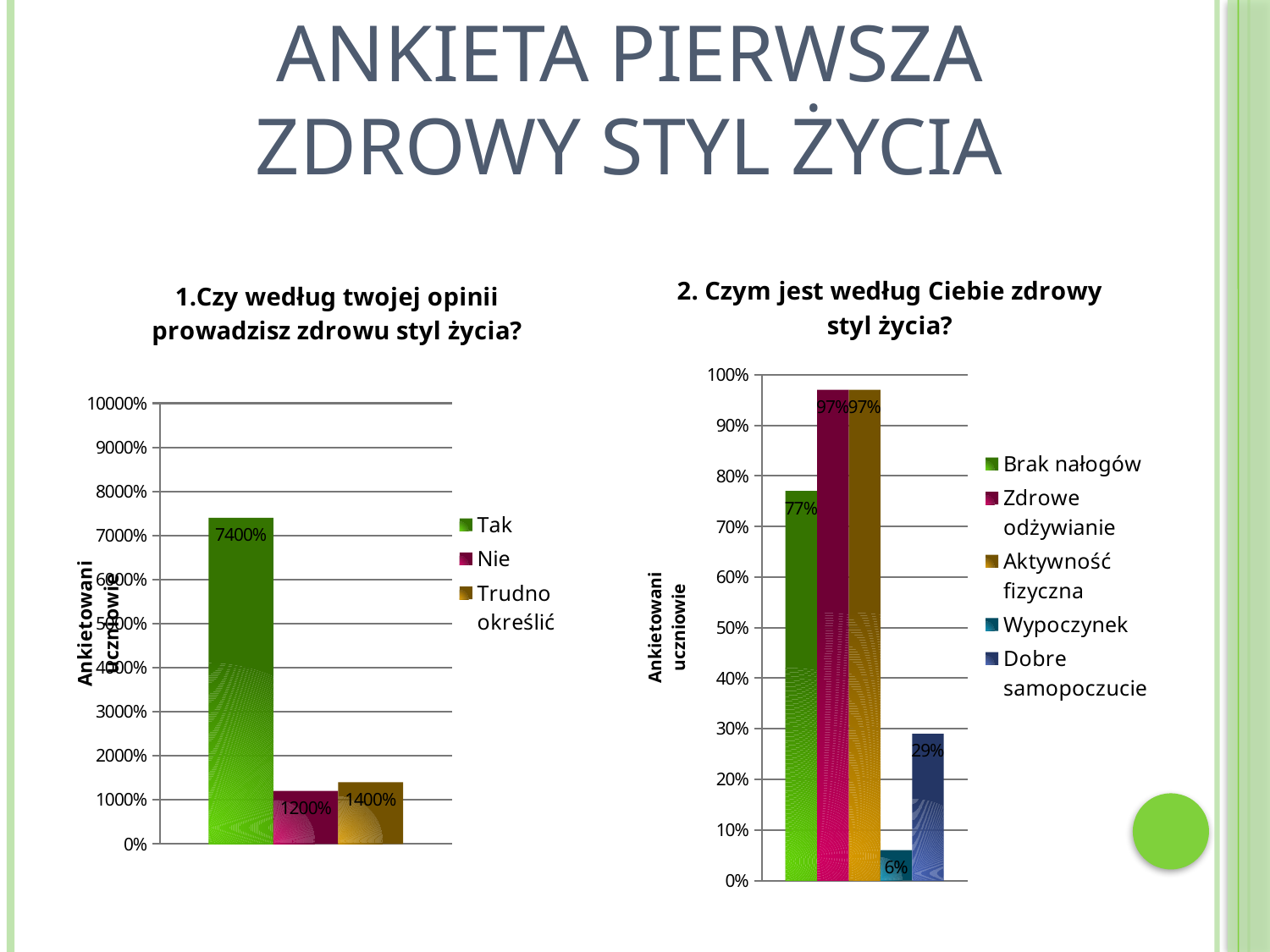
In the chart titled "1.Czy według twojej opinii prowadzisz zdrowu styl życia?", what is the difference between the values for Tak and Trudno określić? 6000% In the chart titled "1.Czy według twojej opinii prowadzisz zdrowu styl życia?", which category has the highest value? Tak In the chart titled "2. Czym jest według Ciebie zdrowy styl życia?", what is the value for Dobre samopoczucie? 29% In the chart titled "2. Czym jest według Ciebie zdrowy styl życia?", what is the difference between the values for Zdrowe odżywianie and Wypoczynek? 91% In the chart titled "2. Czym jest według Ciebie zdrowy styl życia?", which category has the lowest value? Wypoczynek In the chart titled "1.Czy według twojej opinii prowadzisz zdrowu styl życia?", which category has the lowest value? Nie What kind of chart is the chart titled "2. Czym jest według Ciebie zdrowy styl życia?"? Bar chart In the chart titled "2. Czym jest według Ciebie zdrowy styl życia?", what is the value for Brak nałogów? 77% In the chart titled "2. Czym jest według Ciebie zdrowy styl życia?", which is larger, Brak nałogów or Dobre samopoczucie? Brak nałogów In the chart titled "1.Czy według twojej opinii prowadzisz zdrowu styl życia?", what is the value for Tak? 7400% In the chart titled "1.Czy według twojej opinii prowadzisz zdrowu styl życia?", how many series does the legend list? 3 In the chart titled "1.Czy według twojej opinii prowadzisz zdrowu styl życia?", what is the value for Nie? 1200%